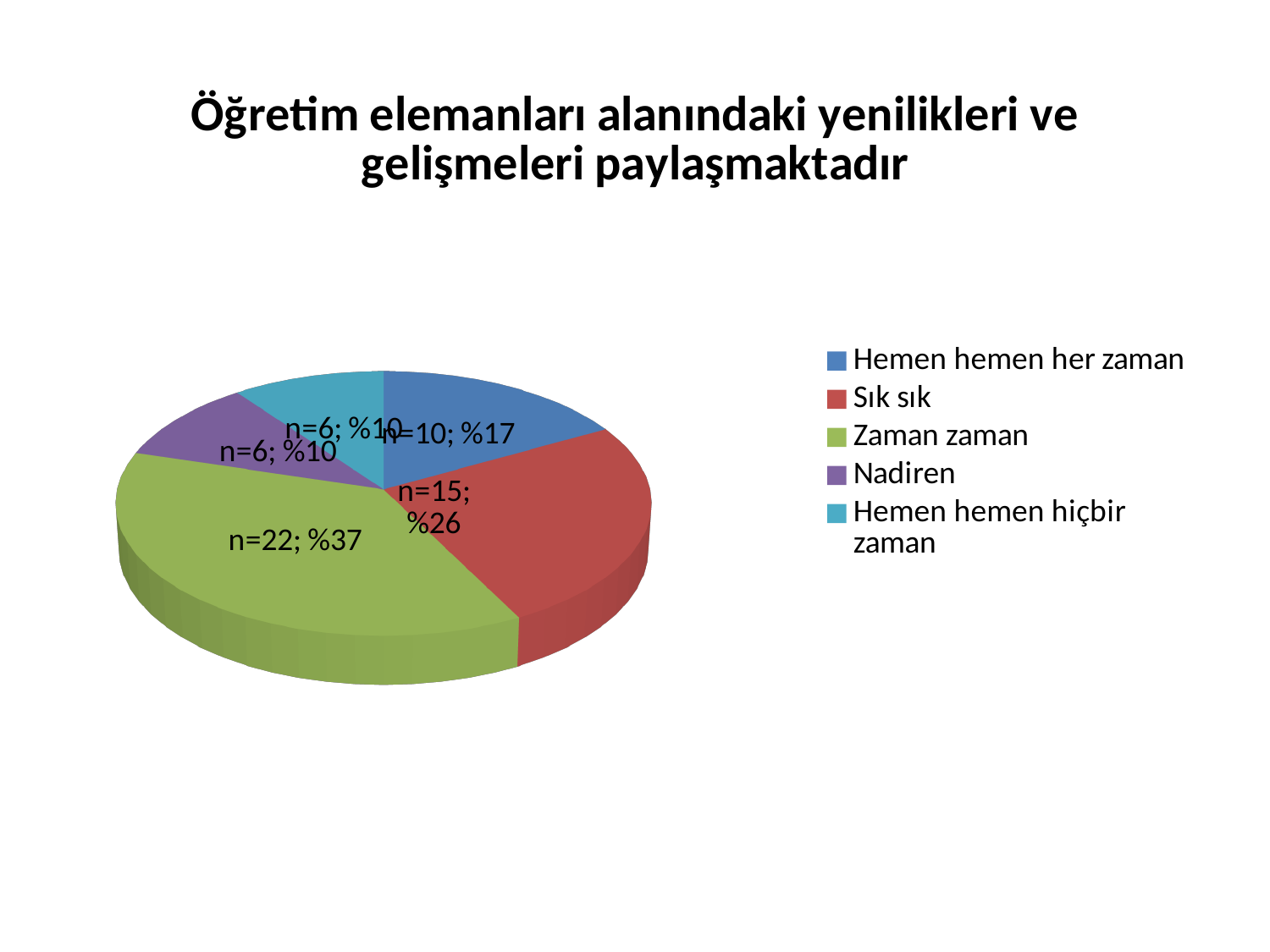
Which category has the largest slice of the pie? Zaman zaman What colour is the 'Zaman zaman' slice in the pie chart? green What is the n value for the 'Zaman zaman' slice? n=22 What percentage share does the 'Hemen hemen her zaman' slice have? %17 What kind of chart is shown on the slide? pie chart What is the title of the chart on the slide? Öğretim elemanları alanındaki yenilikleri ve gelişmeleri paylaşmaktadır Which is larger, the 'Sık sık' slice or the 'Hemen hemen her zaman' slice? Sık sık How many categories does the legend of the pie chart list? 5 What is the n value for the 'Sık sık' slice? n=15 What is the n value for the 'Nadiren' slice? n=6 What is the difference in n between 'Zaman zaman' and 'Sık sık'? 7 What percentage share does the 'Zaman zaman' slice have? %37